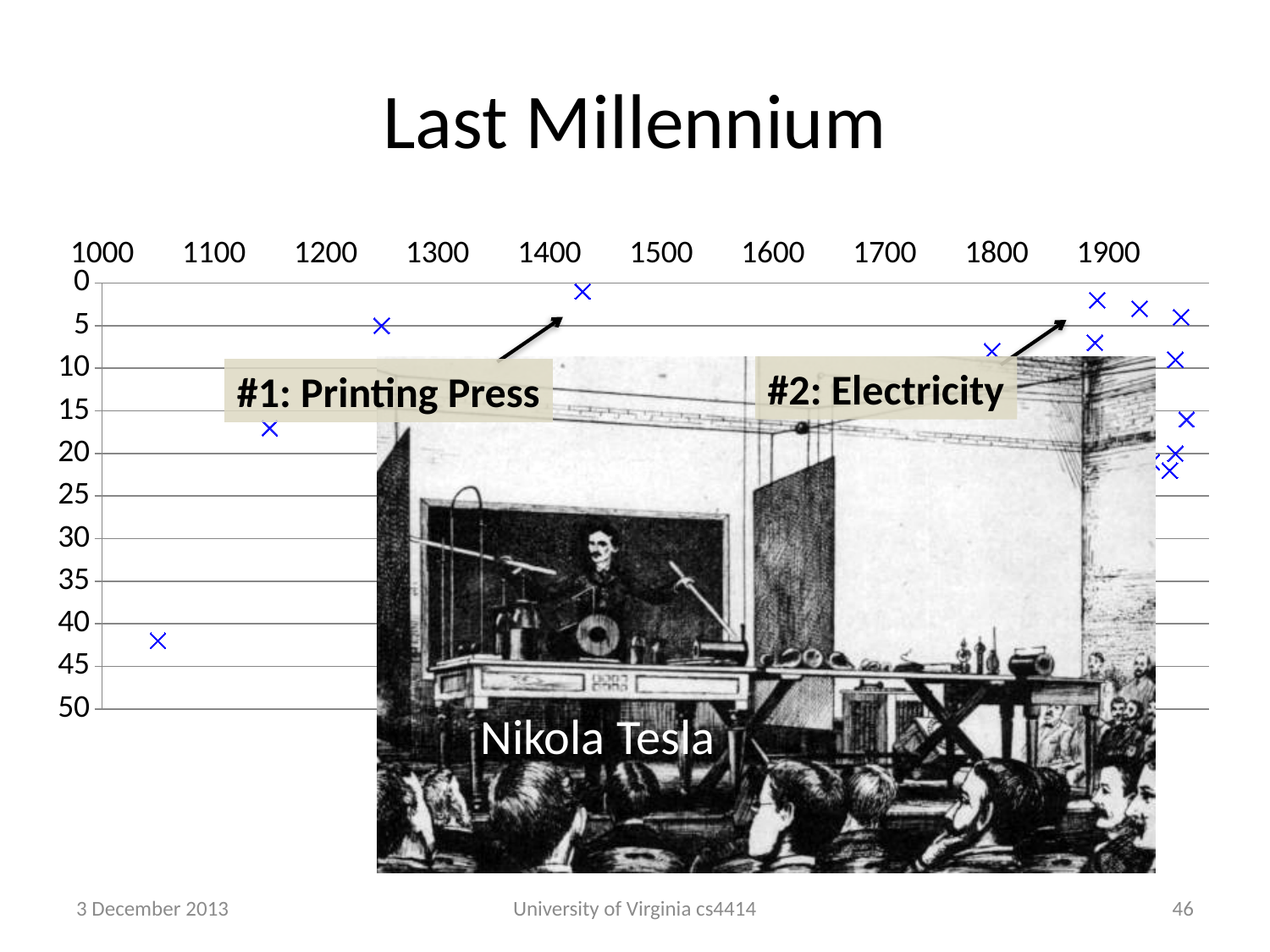
Which labelled point has the smallest value on the chart? #1: Printing Press Is the value of the point plotted between 1100 and 1200 greater or less than 10? greater Between 1000 and 1400 on the x axis, do the plotted values rise or fall? fall Is the value of the point plotted between 1200 and 1300 greater or less than 10? less Is the value of the point labelled '#1: Printing Press' greater or less than 5? less Which two events are labelled with callouts on the chart? #1: Printing Press and #2: Electricity What is the title of the chart on the slide? Last Millennium What kind of chart is shown on the slide? scatter chart Which has the larger value: the point plotted between 1000 and 1100 or the point plotted between 1100 and 1200? the point between 1000 and 1100